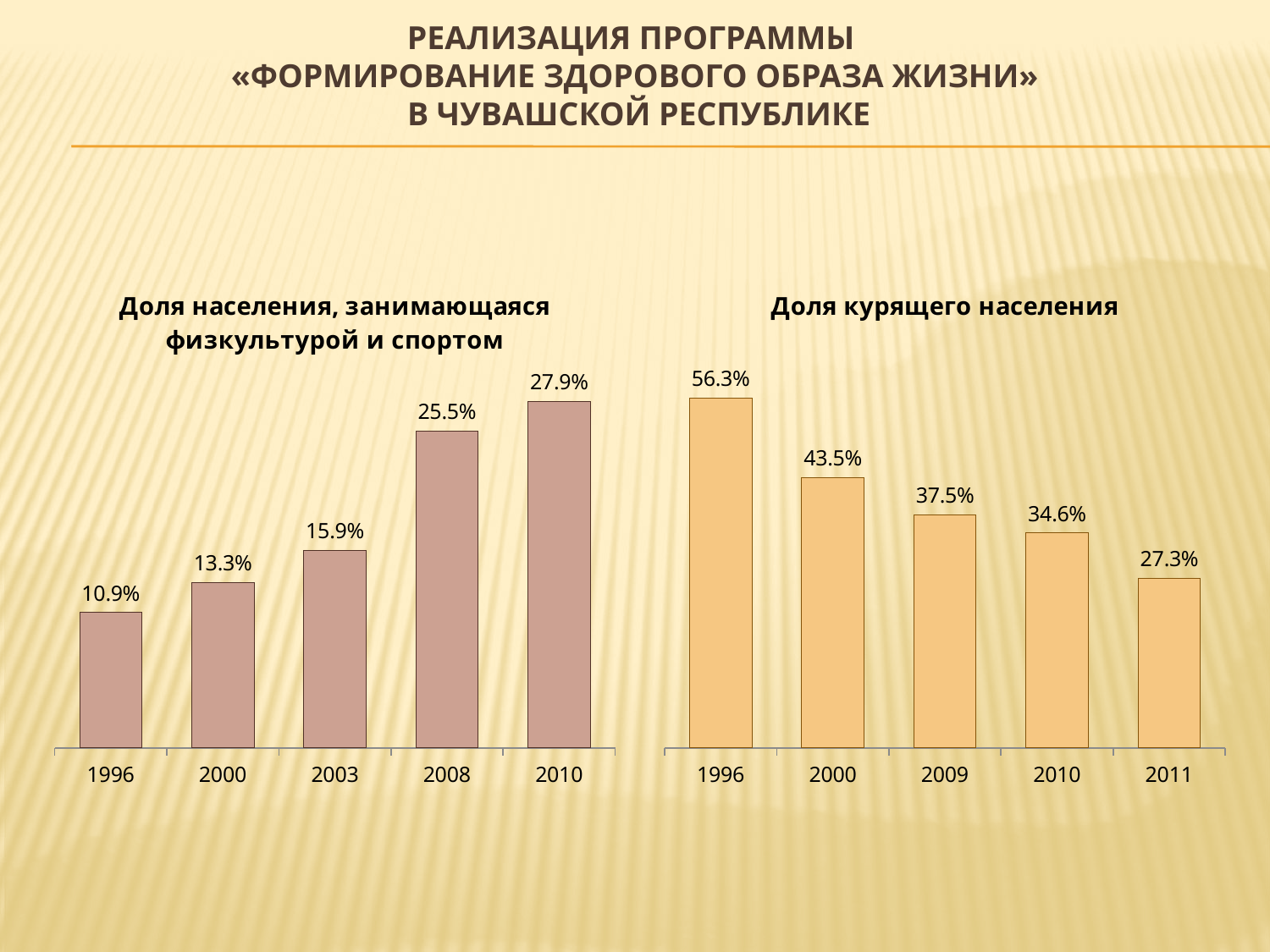
In the right chart (Доля курящего населения), do the values rise or fall from 1996 to 2011? Fall In the right chart (Доля курящего населения), what is the value for 2009? 37.5% In the left chart (Доля населения, занимающаяся физкультурой и спортом), do the values rise or fall from 1996 to 2010? Rise What kind of chart is the right chart (Доля курящего населения)? Bar chart What is the title of the right chart? Доля курящего населения In the left chart (Доля населения, занимающаяся физкультурой и спортом), which year has the highest value? 2010 How many bars are in the left chart (Доля населения, занимающаяся физкультурой и спортом)? 5 In the left chart (Доля населения, занимающаяся физкультурой и спортом), what is the value for 2003? 15.9% In the right chart (Доля курящего населения), which is larger: the value for 2010 or the value for 2011? 2010 In the right chart (Доля курящего населения), what is the difference between the values for 1996 and 2000? 12.8 percentage points In the left chart (Доля населения, занимающаяся физкультурой и спортом), what is the difference between the values for 2010 and 1996? 17 percentage points In the right chart (Доля курящего населения), which year has the lowest value? 2011